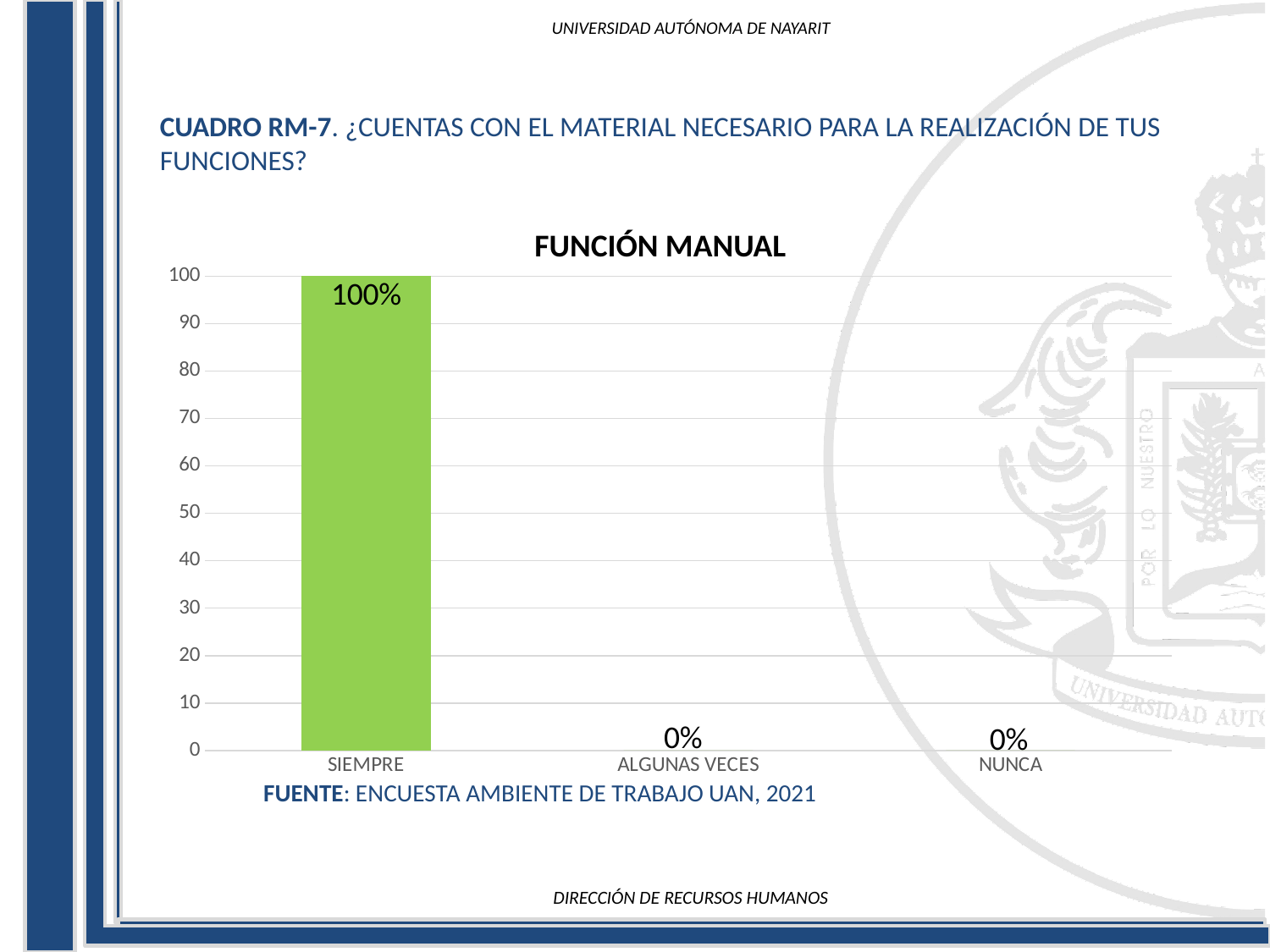
Which category has the highest value? SIEMPRE What is the value for ALGUNAS VECES? 0% What is the value for SIEMPRE? 100% What kind of chart is shown? bar chart Is the value for SIEMPRE greater or less than 50? greater What is the difference between the values for SIEMPRE and NUNCA? 100% Which is larger, the value for SIEMPRE or the value for ALGUNAS VECES? SIEMPRE Do the values rise or fall from SIEMPRE to NUNCA along the x axis? fall What is the title of the chart? FUNCIÓN MANUAL What colour is the bar for SIEMPRE? green How many categories are shown on the x axis? 3 What is the value for NUNCA? 0%